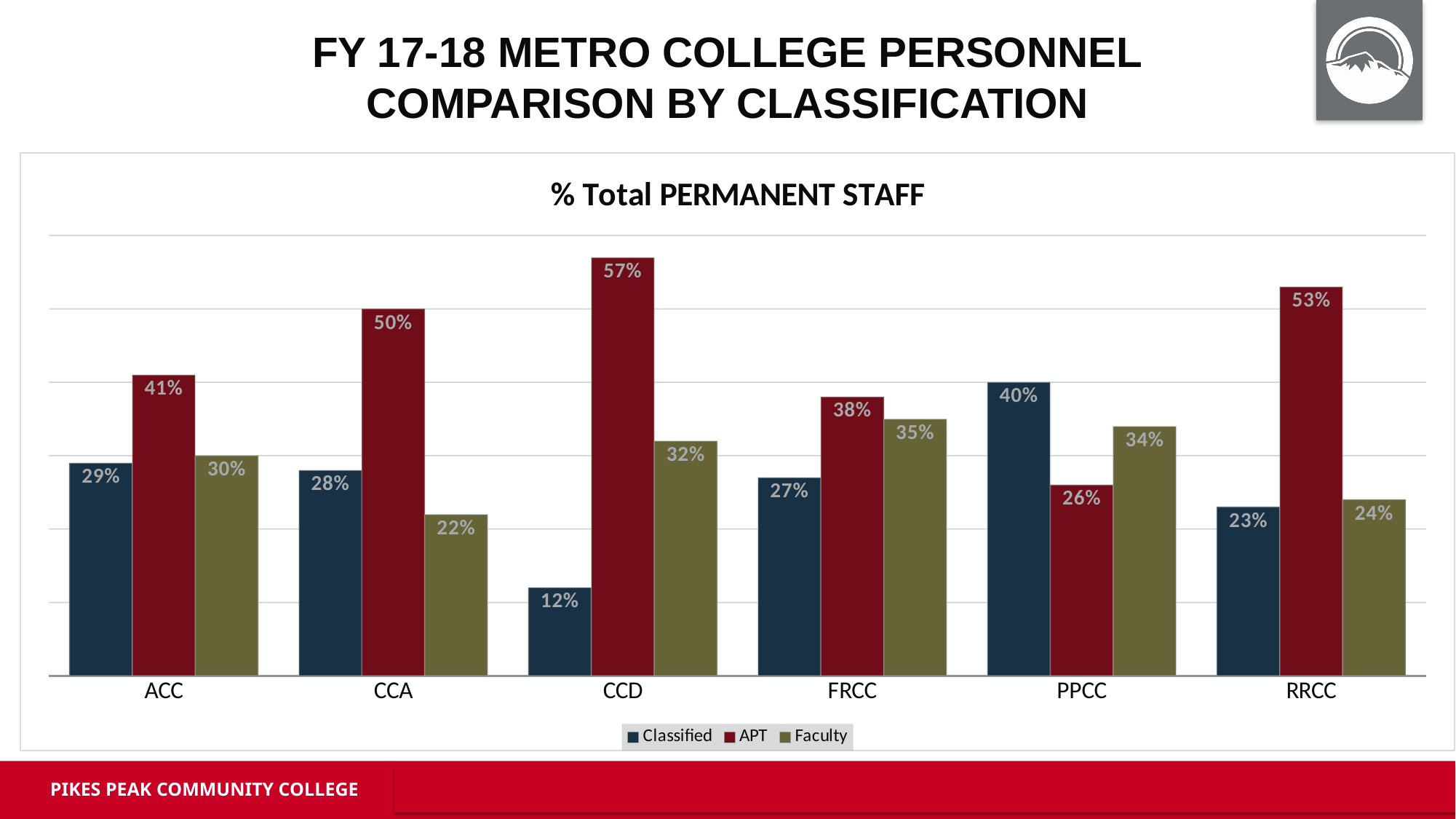
What is the Faculty value for CCA? 22% What is the title of the chart? % Total PERMANENT STAFF How many colleges are shown on the x axis? 6 What is the difference between the APT and Classified values for RRCC? 30% What kind of chart is shown? Bar chart What is the APT value for CCD? 57% Which college has the lowest Classified value? CCD Which college has the highest APT value? CCD Which series is shown in dark red? APT What is the Classified value for PPCC? 40% How many series does the legend list? 3 Which is larger for FRCC, the APT value or the Faculty value? APT